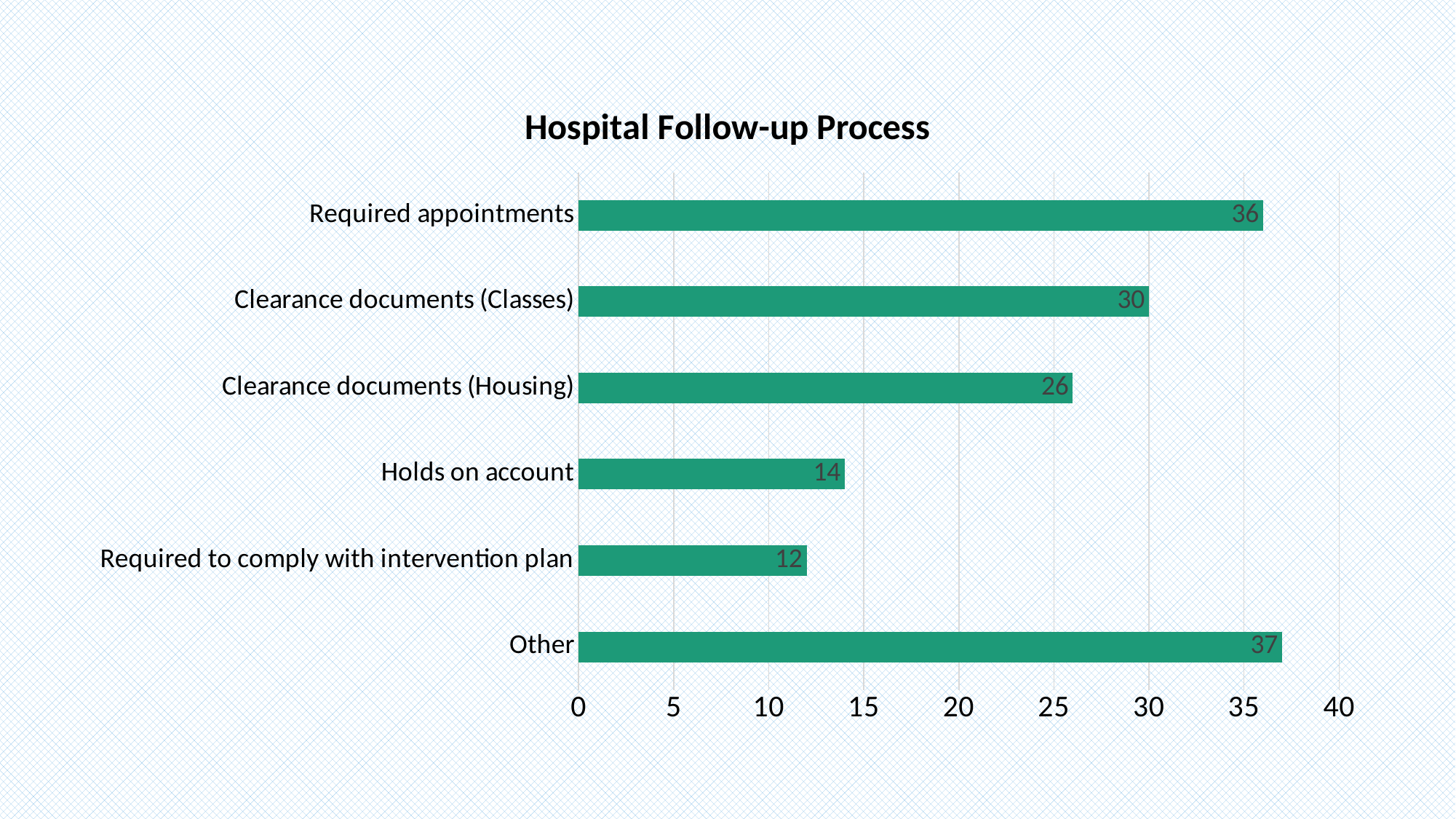
How many categories are shown in the chart? 6 Which category has the highest value? Other What is the value for Holds on account? 14 Which is larger, the value for Clearance documents (Classes) or Clearance documents (Housing)? Clearance documents (Classes) What kind of chart is shown on the slide? Bar chart What is the value for Required to comply with intervention plan? 12 What is the title of the chart? Hospital Follow-up Process Which category has the lowest value? Required to comply with intervention plan What is the difference between the values for Required appointments and Clearance documents (Classes)? 6 What is the value for Required appointments? 36 What is the value for Clearance documents (Housing)? 26 Is the value for Clearance documents (Housing) greater or less than 20? greater